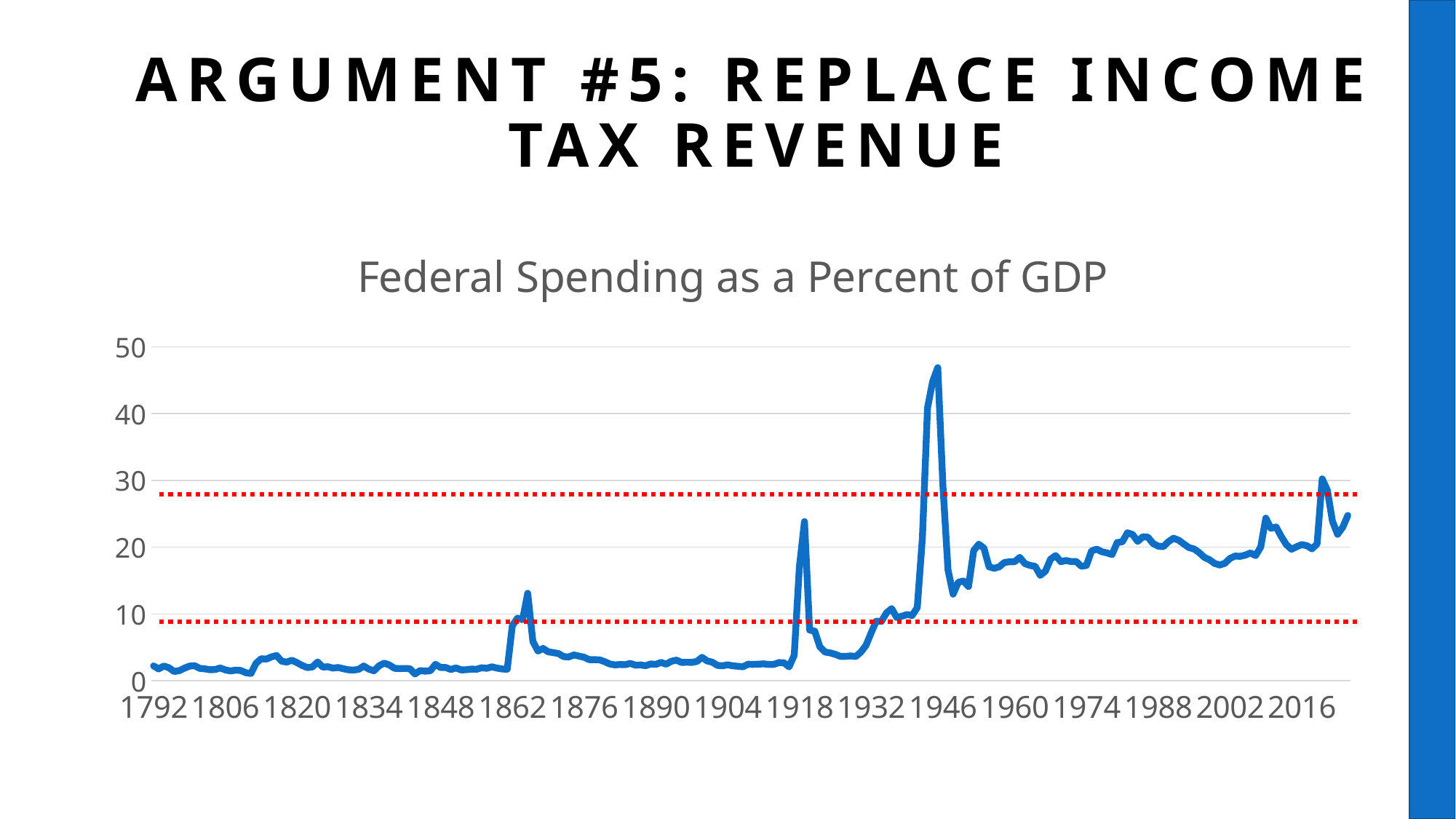
Overall, do the values rise or fall from 1792 to 2016? rise Is the value for 1792 greater or less than 10? less What is the first year labeled on the x axis? 1792 Which year has the larger value, 1918 or 1876? 1918 What kind of chart is shown on the slide? line chart How many year labels are shown on the x axis? 17 What is the title of the chart? Federal Spending as a Percent of GDP Is the value for 2002 greater or less than 10? greater Which year has the larger value, 1792 or 1960? 1960 Is the highest value on the chart greater or less than 40? greater